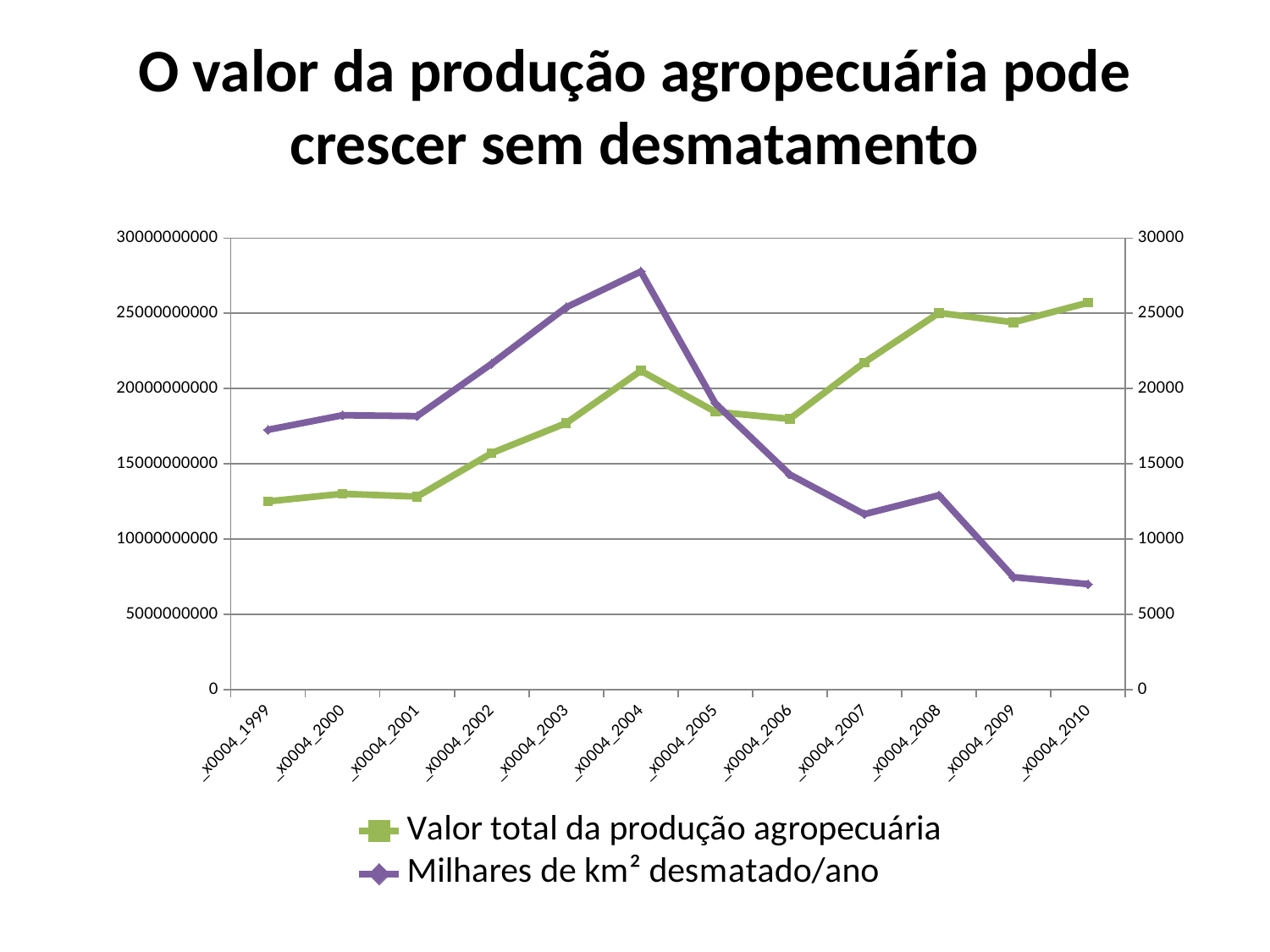
Does the series 'Milhares de km² desmatado/ano' rise or fall from _x0004_2004 to _x0004_2010? fall At which x-axis category does the series 'Milhares de km² desmatado/ano' reach its highest value? _x0004_2004 How many series does the legend list? 2 Is the value of 'Valor total da produção agropecuária' at _x0004_2004 greater or less than 20000000000 on the left axis? greater Is the value of 'Milhares de km² desmatado/ano' at _x0004_2004 greater or less than 25000 on the right axis? greater Is the value of 'Valor total da produção agropecuária' at _x0004_1999 greater or less than 15000000000 on the left axis? less What kind of chart is shown on the slide? line chart For 'Milhares de km² desmatado/ano', which is larger: the value at _x0004_2003 or at _x0004_2006? _x0004_2003 How many points are plotted along the x axis for each series? 12 For 'Valor total da produção agropecuária', which is larger: the value at _x0004_2008 or at _x0004_2005? _x0004_2008 Which colour is used for the series 'Valor total da produção agropecuária'? green